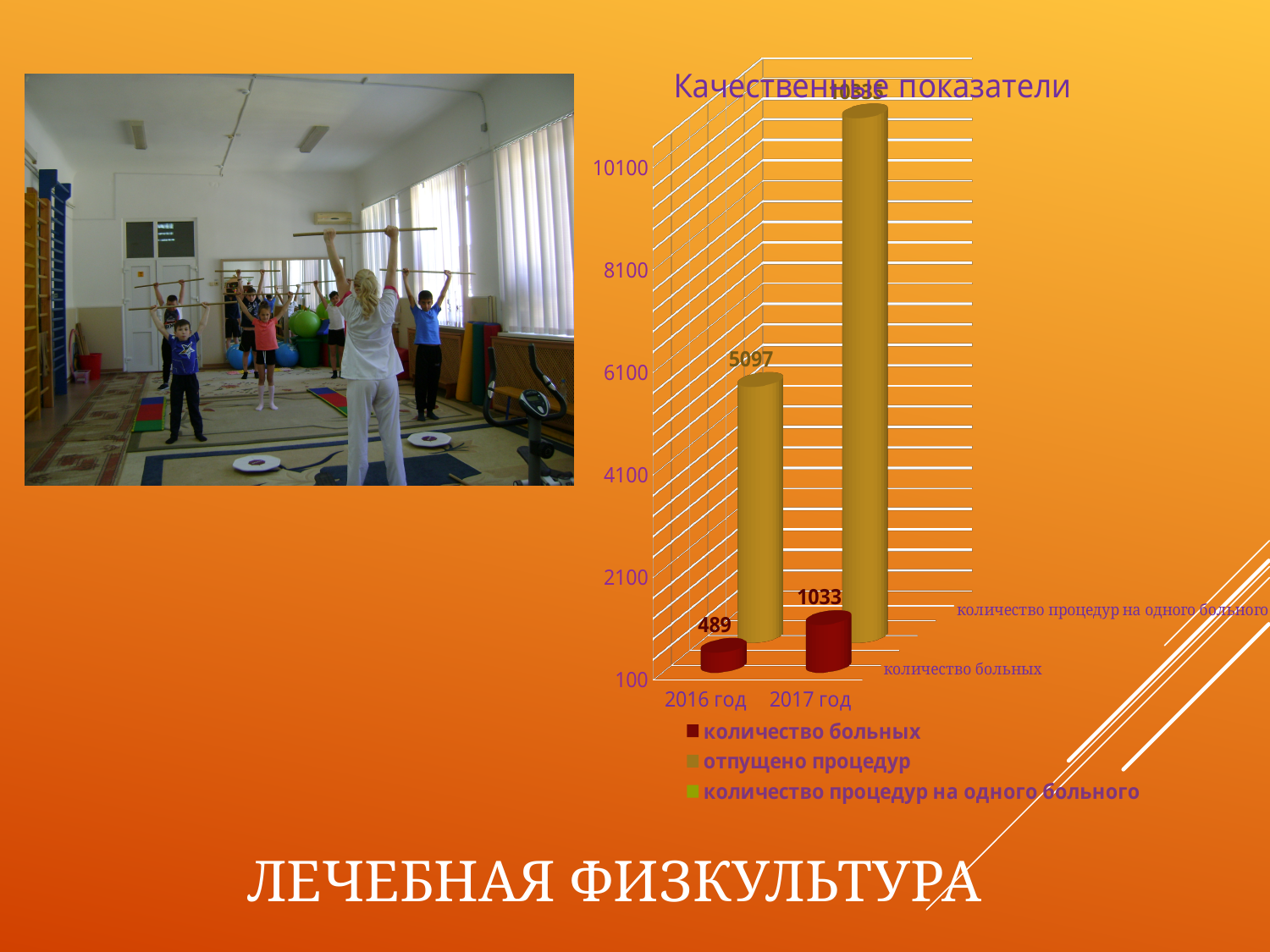
By how much did количество больных increase from 2016 год to 2017 год? 544 How many years (categories) are shown on the x axis of the chart? 2 What is the value of отпущено процедур for 2016 год? 5097 Which year has the larger value for количество больных, 2016 год or 2017 год? 2017 год What kind of chart is shown on the slide? bar chart What is the value of количество больных for 2016 год? 489 Is the value of отпущено процедур for 2017 год greater or less than 10100? greater What is the value of количество больных for 2017 год? 1033 How many series does the chart legend list? 3 Is the value of отпущено процедур for 2016 год greater or less than 6100? less What is the title of the chart? Качественные показатели Does the value of количество больных rise or fall from 2016 год to 2017 год? rise